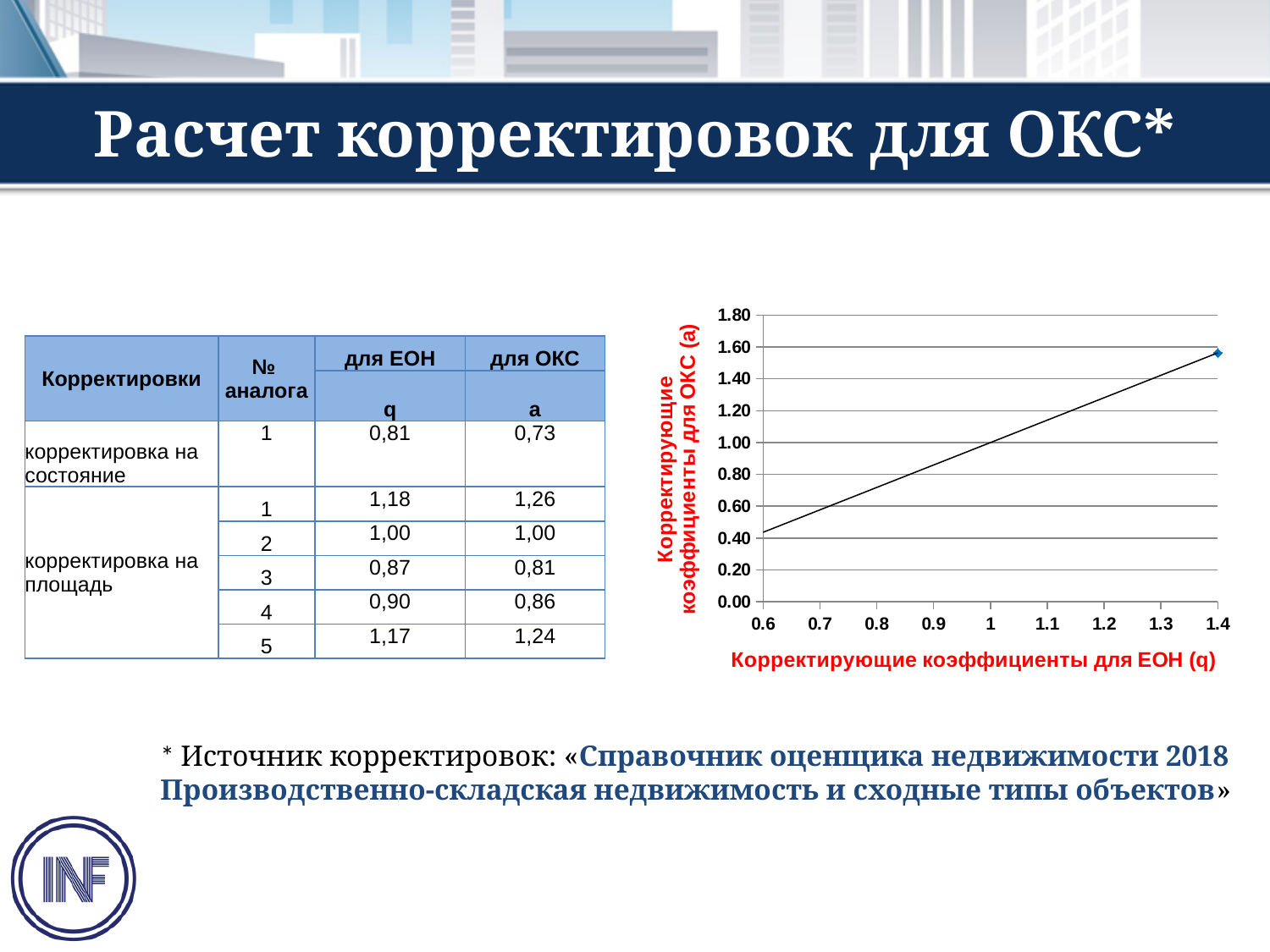
What is the highest tick value shown on the y axis of the chart? 1.80 What is the title of the y axis of the chart? Корректирующие коэффициенты для ОКС (a) Is the value of a at q = 1.3 greater or less than 1.20? greater Which is larger on the chart: the value of a at q = 1.4 or at q = 0.6? q = 1.4 Is the value of a at q = 0.7 greater or less than 0.80? less Is the value of a at q = 1.4 greater or less than 1.40? greater What is the title of the x axis of the chart? Корректирующие коэффициенты для ЕОН (q) How many tick labels are shown on the x axis of the chart? 9 Do the values on the chart rise or fall as q increases along the x axis? rise What kind of chart is shown on the slide? line chart What is the lowest tick value shown on the x axis of the chart? 0.6